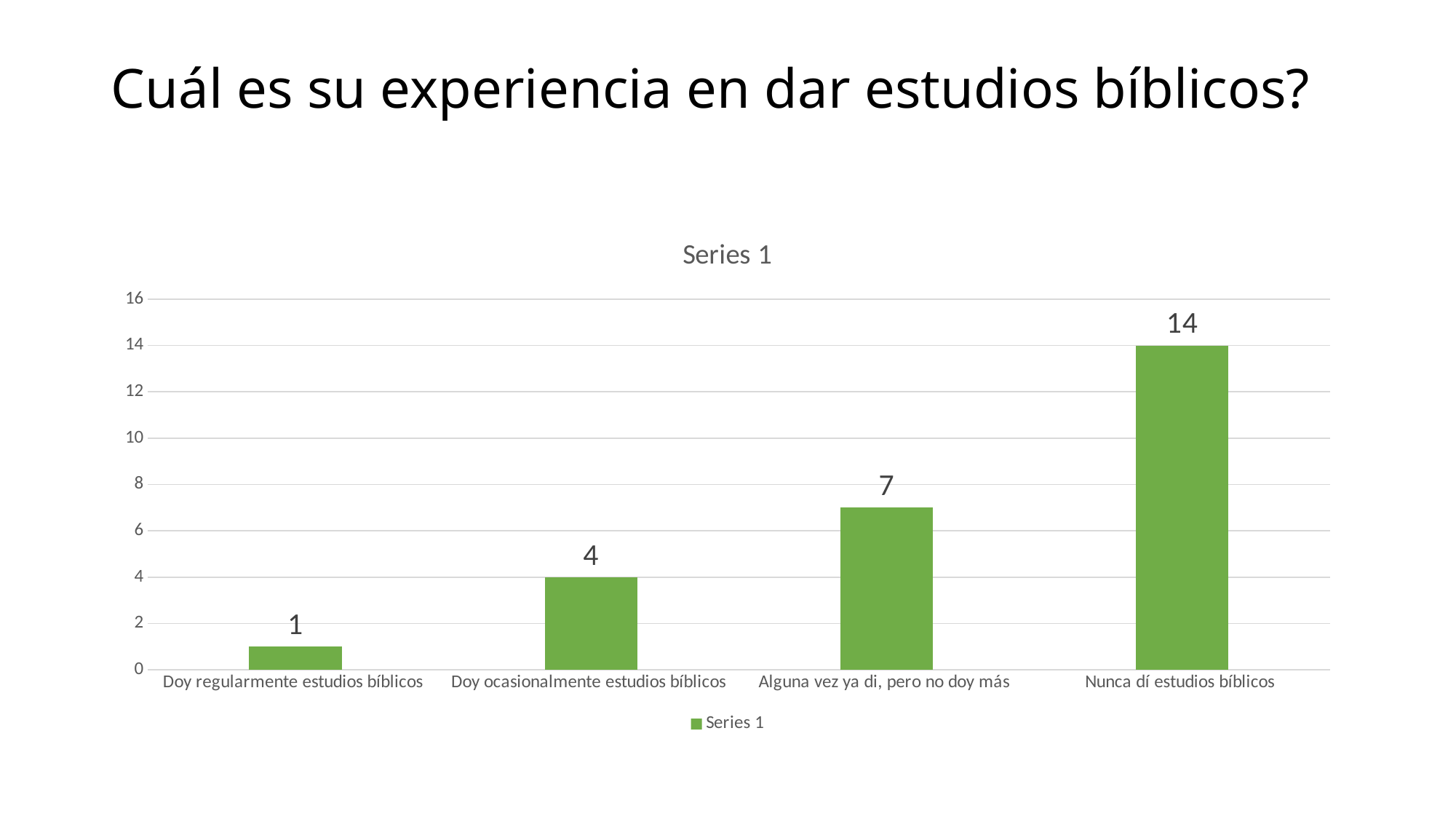
Is the value for "Nunca dí estudios bíblicos" greater or less than 10? greater How many categories are shown on the x axis? 4 What is the value for "Nunca dí estudios bíblicos"? 14 How many series does the legend list? 1 What is the difference between the values for "Nunca dí estudios bíblicos" and "Alguna vez ya di, pero no doy más"? 7 What kind of chart is shown on the slide? bar chart Which category has the lowest value? Doy regularmente estudios bíblicos Which is larger: the value for "Doy ocasionalmente estudios bíblicos" or "Alguna vez ya di, pero no doy más"? Alguna vez ya di, pero no doy más What is the value for "Alguna vez ya di, pero no doy más"? 7 What is the value for "Doy ocasionalmente estudios bíblicos"? 4 Which category has the highest value? Nunca dí estudios bíblicos Do the values rise or fall from left to right along the x axis? rise